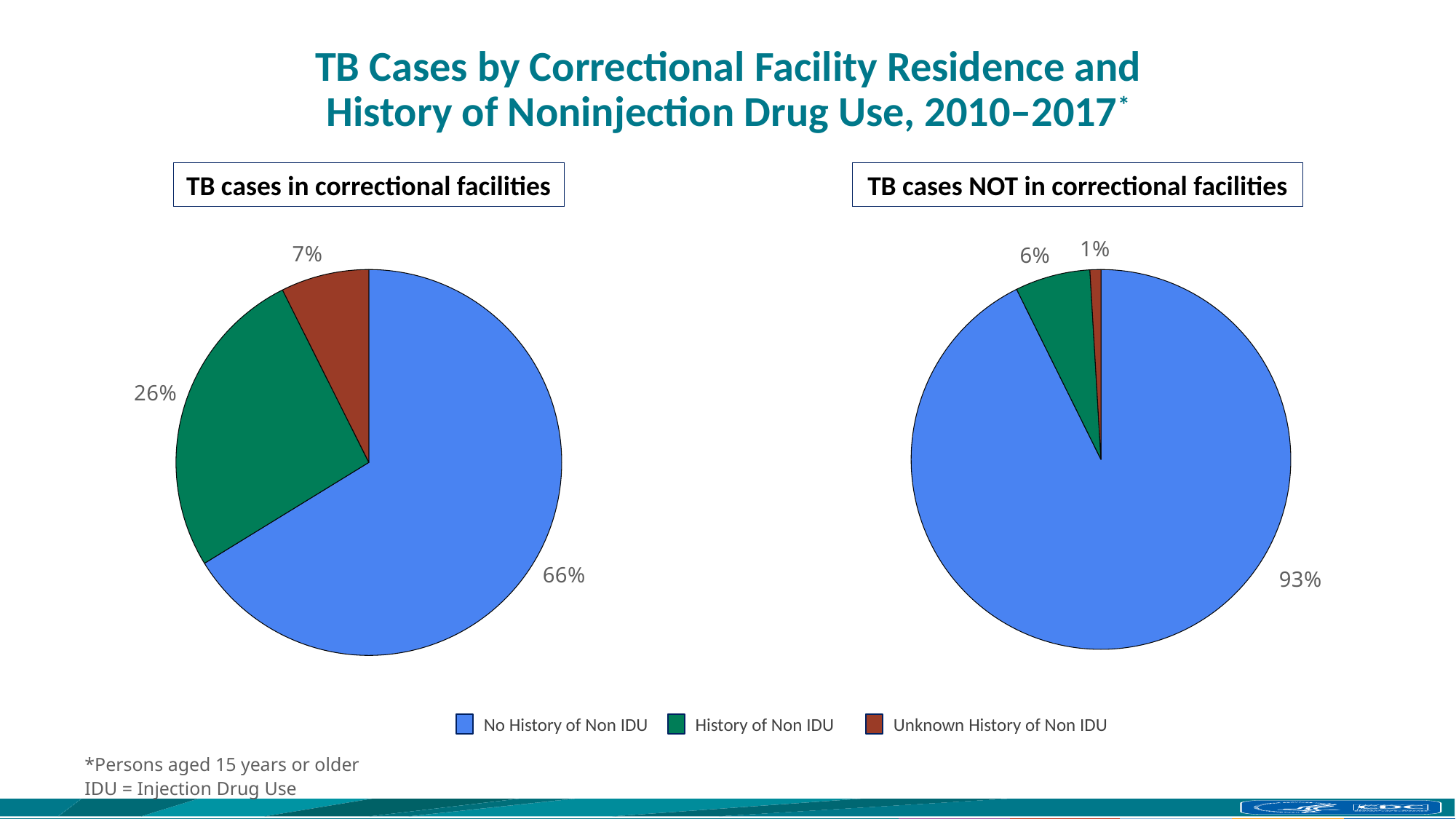
Which chart has the larger share of No History of Non IDU: 'TB cases in correctional facilities' or 'TB cases NOT in correctional facilities'? TB cases NOT in correctional facilities What type of chart is used on this slide? Pie chart How many categories does the legend list? 3 In the 'TB cases in correctional facilities' pie chart, which category has the largest slice? No History of Non IDU In the 'TB cases NOT in correctional facilities' pie chart, what share of cases have a History of Non IDU? 6% In the 'TB cases NOT in correctional facilities' pie chart, what share of cases have No History of Non IDU? 93% In the 'TB cases in correctional facilities' pie chart, what share of cases have a History of Non IDU? 26% What is the difference between the History of Non IDU share in the 'TB cases in correctional facilities' chart and in the 'TB cases NOT in correctional facilities' chart? 20 percentage points In the 'TB cases NOT in correctional facilities' pie chart, which category has the smallest slice? Unknown History of Non IDU